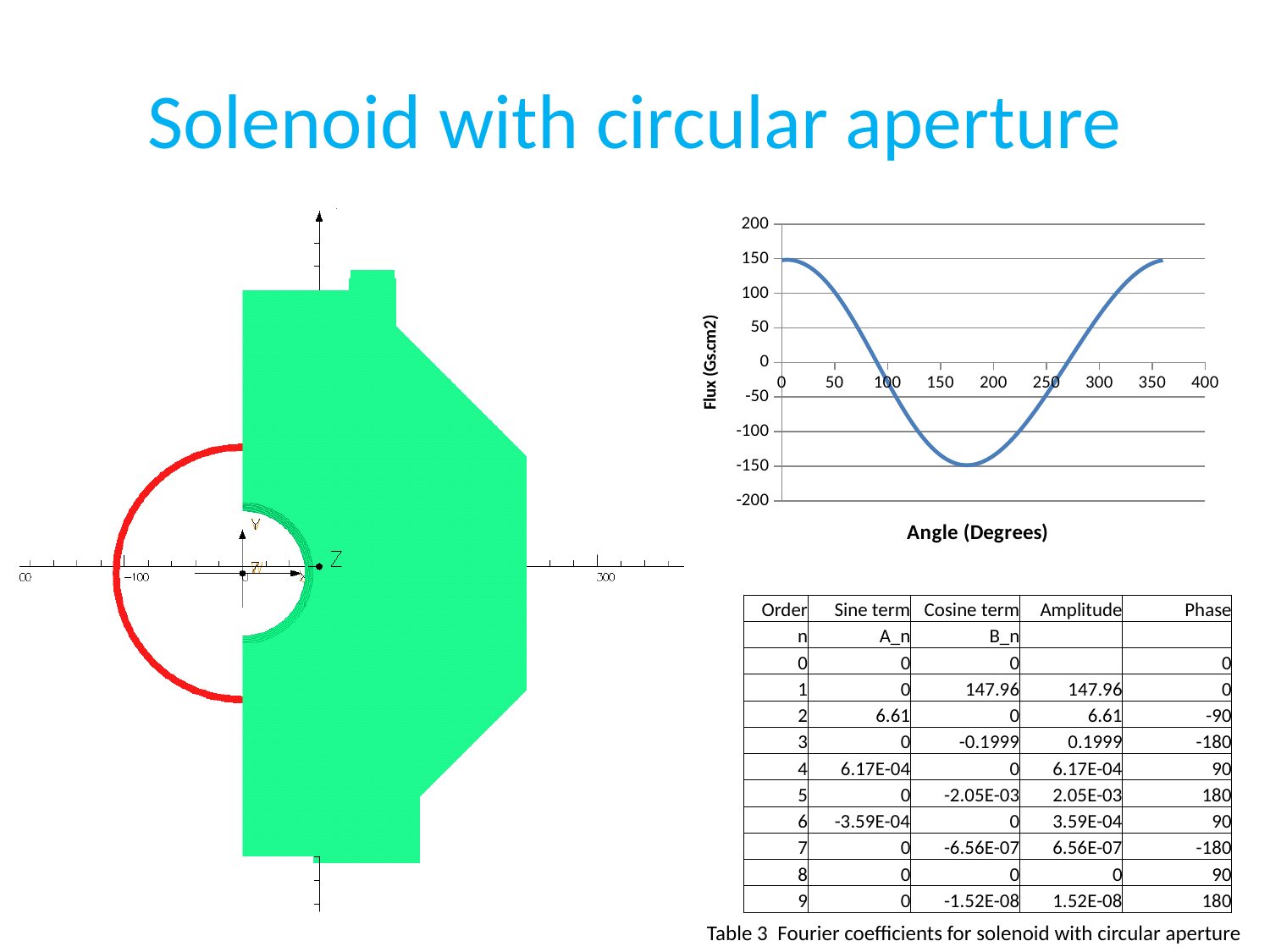
In the flux chart, does the flux rise or fall as the angle increases from 180 to 360 degrees? rise In the flux chart, does the flux rise or fall as the angle increases from 0 to 180 degrees? fall In the flux chart, is the flux at an angle of 50 degrees greater or less than 50? greater In the flux chart, is the flux at an angle of 180 degrees greater or less than -100? less In the flux chart, is the flux at an angle of 300 degrees greater or less than 50? greater What is the label of the vertical axis of the flux chart? Flux (Gs.cm2) In the flux chart, which is larger: the flux at 0 degrees or the flux at 180 degrees? 0 degrees What is the label of the horizontal axis of the flux chart? Angle (Degrees) What kind of chart is shown on the right of the slide? line chart